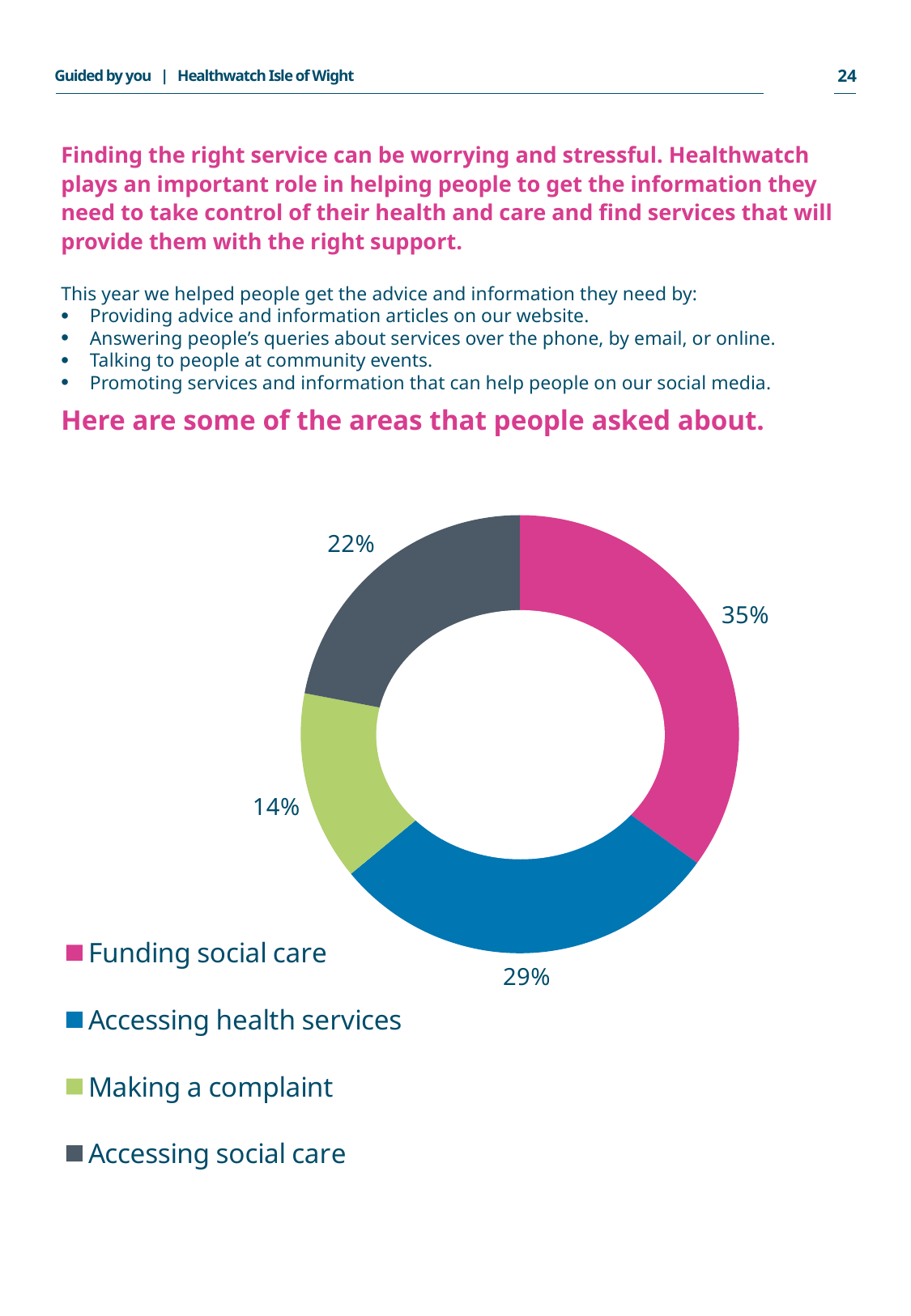
What percentage of the chart is for Making a complaint? 14% How many categories are shown in the chart? 4 Which is larger: Accessing health services or Accessing social care? Accessing health services What kind of chart is shown on the slide? Doughnut chart Which area has the largest share of the chart? Funding social care Which area has the smallest share of the chart? Making a complaint What colour is the Making a complaint segment? Green What is the difference in percentage points between Accessing health services and Accessing social care? 7 What is the difference in percentage points between Funding social care and Making a complaint? 21 What percentage of the chart is for Accessing health services? 29% What percentage of the chart is for Accessing social care? 22% What percentage of the chart is for Funding social care? 35%